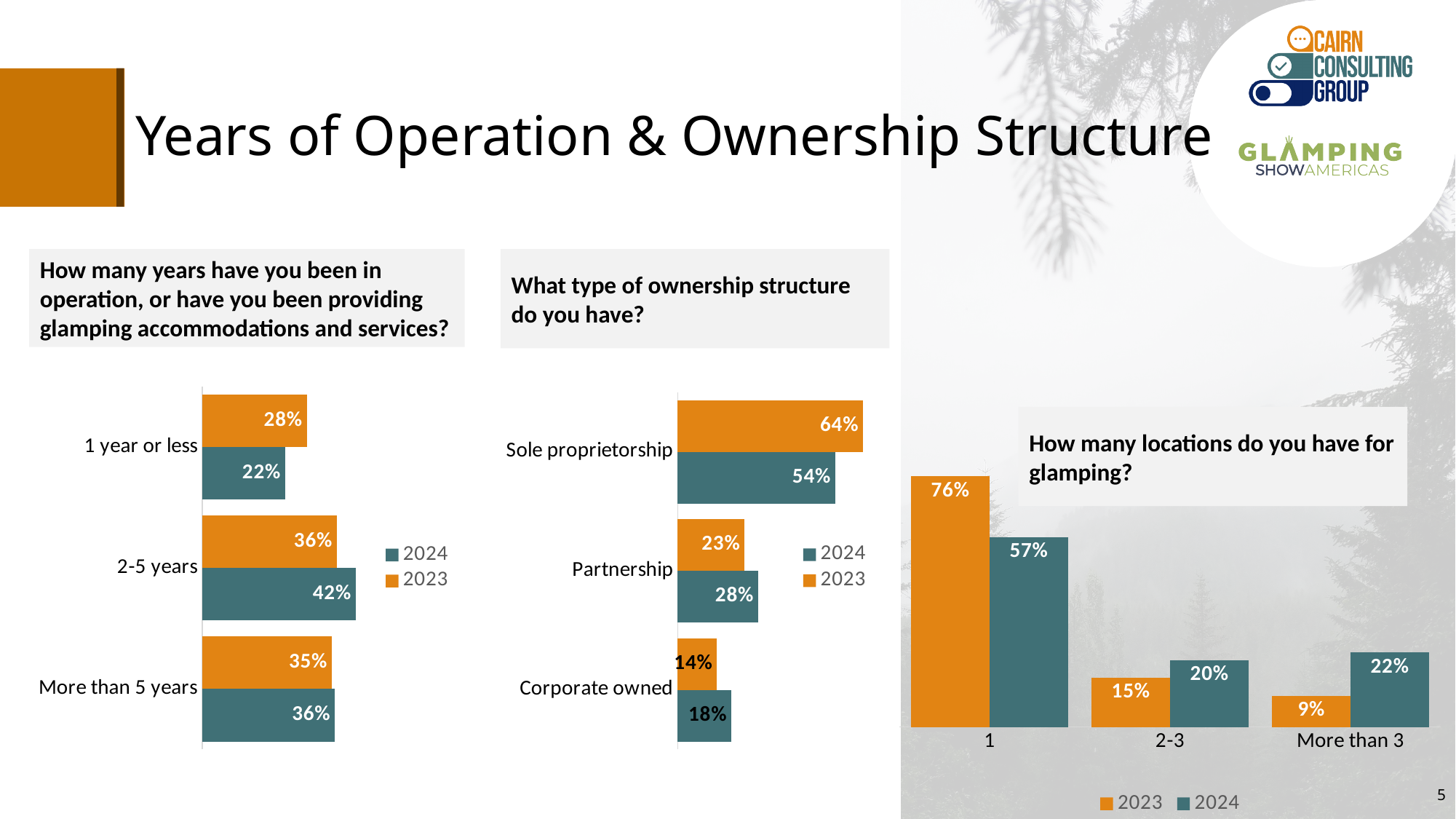
What type of chart is the locations chart? Bar chart In the ownership structure chart, how many categories are shown? 3 In the ownership structure chart, what is the 2023 value for 'Sole proprietorship'? 64% In the locations chart, which category has the highest 2024 value? 1 In the locations chart, what is the difference between the 2023 and 2024 values for '1'? 19% In the ownership structure chart, which is larger for 'Partnership': the 2023 value or the 2024 value? 2024 In the years-in-operation chart, what is the 2024 value for '2-5 years'? 42% In the locations chart, what is the 2023 value for 'More than 3'? 9% In the ownership structure chart, which category has the lowest 2024 value? Corporate owned In the years-in-operation chart, what is the difference between the 2023 and 2024 values for '1 year or less'? 6% How many series does the legend of the years-in-operation chart list? 2 In the years-in-operation chart, what is the 2023 value for '1 year or less'? 28%